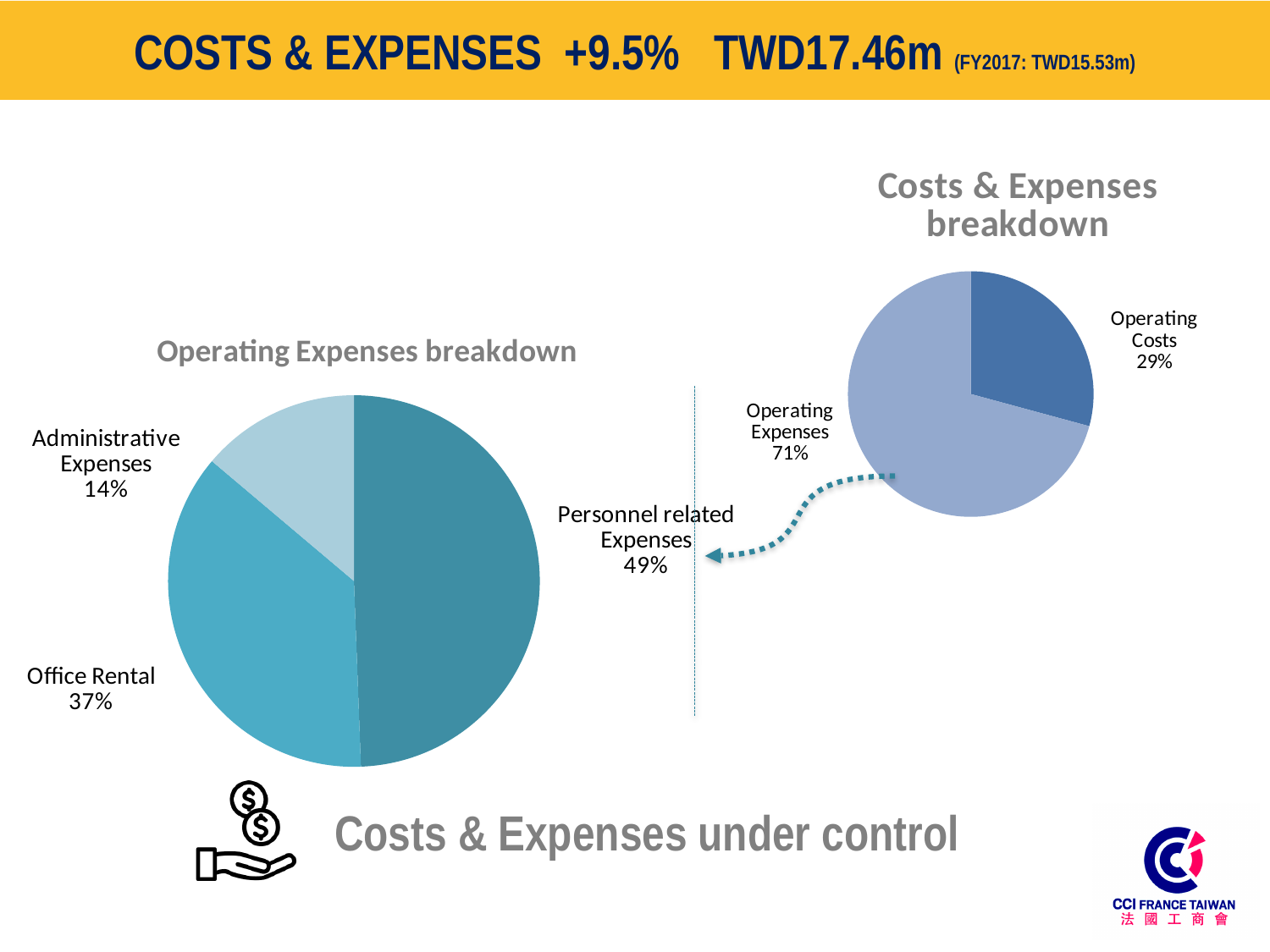
What type of chart is the Costs & Expenses breakdown chart? Pie chart In the Operating Expenses breakdown chart, which is larger: Office Rental or Personnel related Expenses? Personnel related Expenses In the Operating Expenses breakdown chart, what is the difference in percentage points between Office Rental and Administrative Expenses? 23 In the Operating Expenses breakdown chart, which category has the largest share? Personnel related Expenses In the Operating Expenses breakdown chart, which category has the smallest share? Administrative Expenses How many categories does the Operating Expenses breakdown chart show? 3 In the Operating Expenses breakdown chart, what share is Office Rental? 37% In the Operating Expenses breakdown chart, what share is Administrative Expenses? 14% In the Costs & Expenses breakdown chart, what is the difference in percentage points between Operating Expenses and Operating Costs? 42 In the Costs & Expenses breakdown chart, what share is Operating Expenses? 71% In the Operating Expenses breakdown chart, what share is Personnel related Expenses? 49% In the Costs & Expenses breakdown chart, what share is Operating Costs? 29%